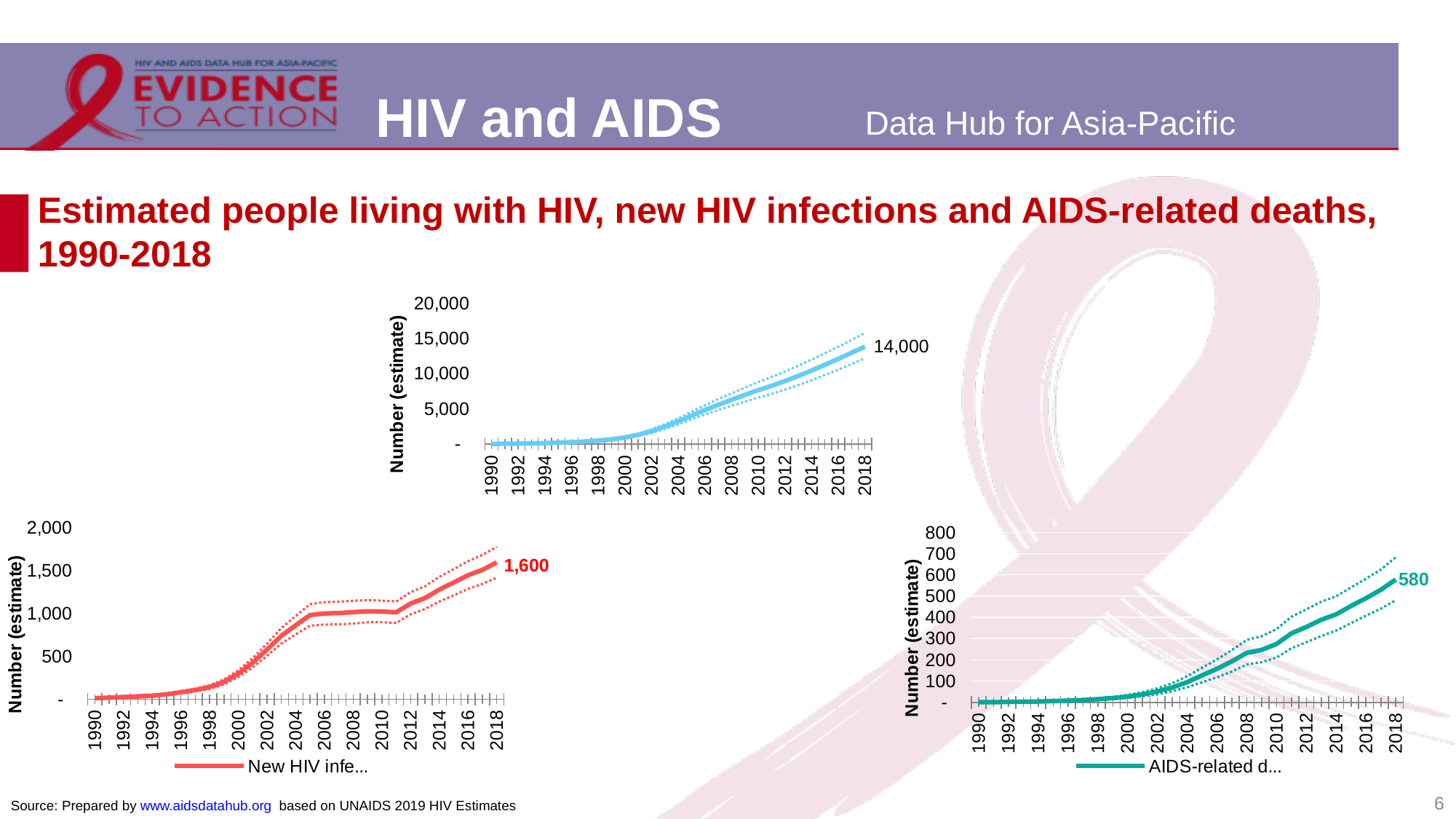
In the top chart, is the value for 2010 greater or less than 5,000? greater In the bottom-left chart (New HIV infections), what is the labelled value for 2018? 1,600 Which is larger in 2018: the labelled value in the bottom-left chart or the labelled value in the bottom-right chart? bottom-left chart (1,600) What is the y-axis title of the bottom-right chart? Number (estimate) What kind of chart is the bottom-left chart? line chart In the bottom-right chart, is the value for 2000 greater or less than 100? less What is the highest tick value shown on the y axis of the top chart? 20,000 In the bottom-right chart (AIDS-related deaths), what is the labelled value for 2018? 580 In the top chart, do the values rise or fall from 1990 to 2018? rise In the top chart, what is the labelled value at the end of the line in 2018? 14,000 What is the difference between the 2018 labelled value in the bottom-left chart (1,600) and the 2018 labelled value in the bottom-right chart (580)? 1,020 In the bottom-left chart, is the value for 2010 greater or less than 500? greater